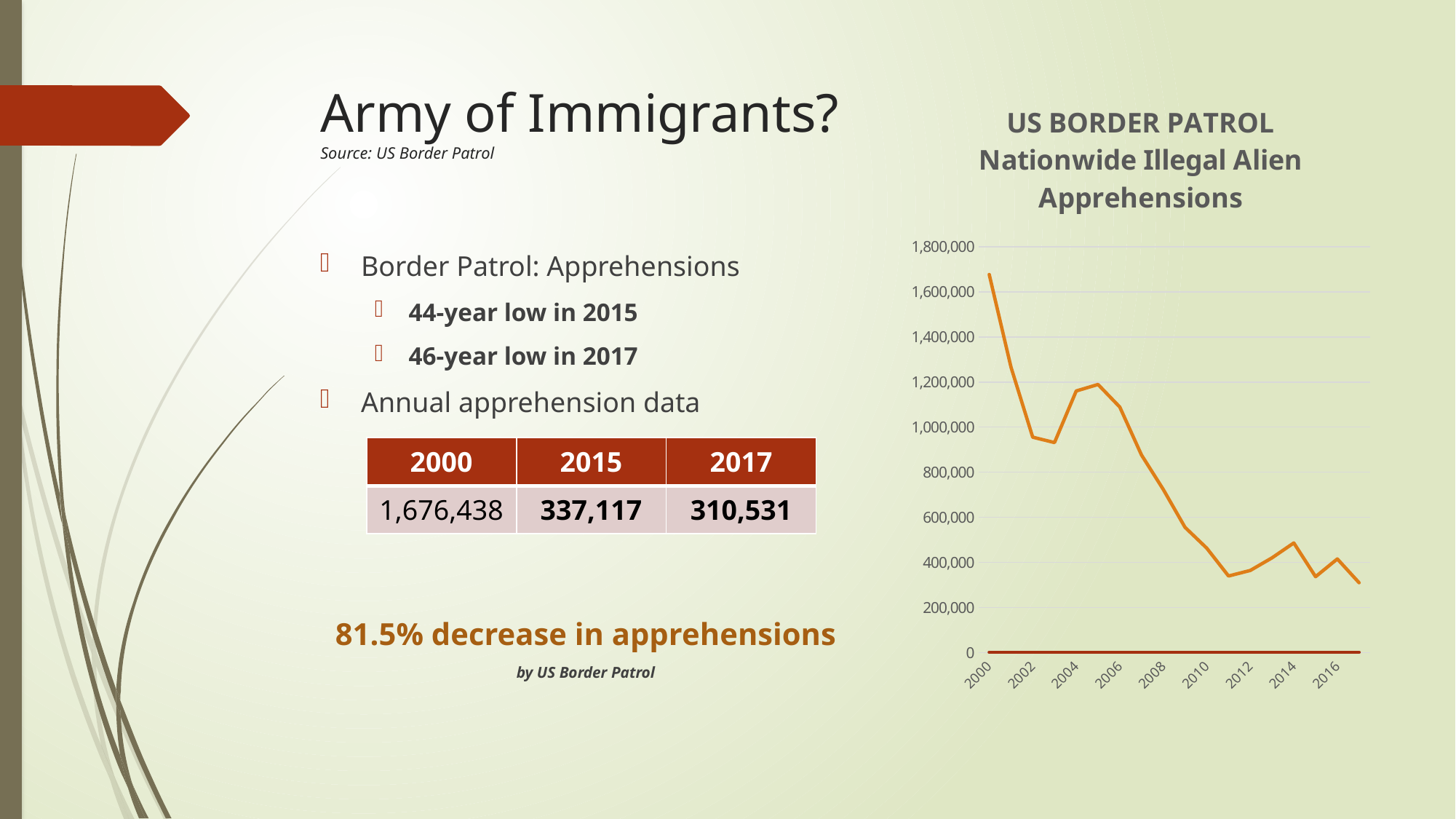
In the US Border Patrol apprehensions chart, which year has the highest value? 2000 According to the table on the slide, what is the apprehension value plotted for 2000 in the US Border Patrol chart? 1,676,438 In the US Border Patrol apprehensions chart, is the value for 2008 greater or less than 800,000? less In the US Border Patrol apprehensions chart, is the value for 2005 greater or less than 1,000,000? greater In the US Border Patrol apprehensions chart, is the value for 2011 greater or less than 400,000? less In the US Border Patrol apprehensions chart, do the values generally rise or fall from 2000 to the end of the series? fall In the US Border Patrol apprehensions chart, which year has the larger value, 2000 or 2017? 2000 Using the values in the table, what is the difference between the 2000 and 2017 apprehension values plotted in the chart? 1,365,907 What kind of chart is shown under the title "US BORDER PATROL Nationwide Illegal Alien Apprehensions"? line chart In the US Border Patrol apprehensions chart, which year has the lowest value? 2017